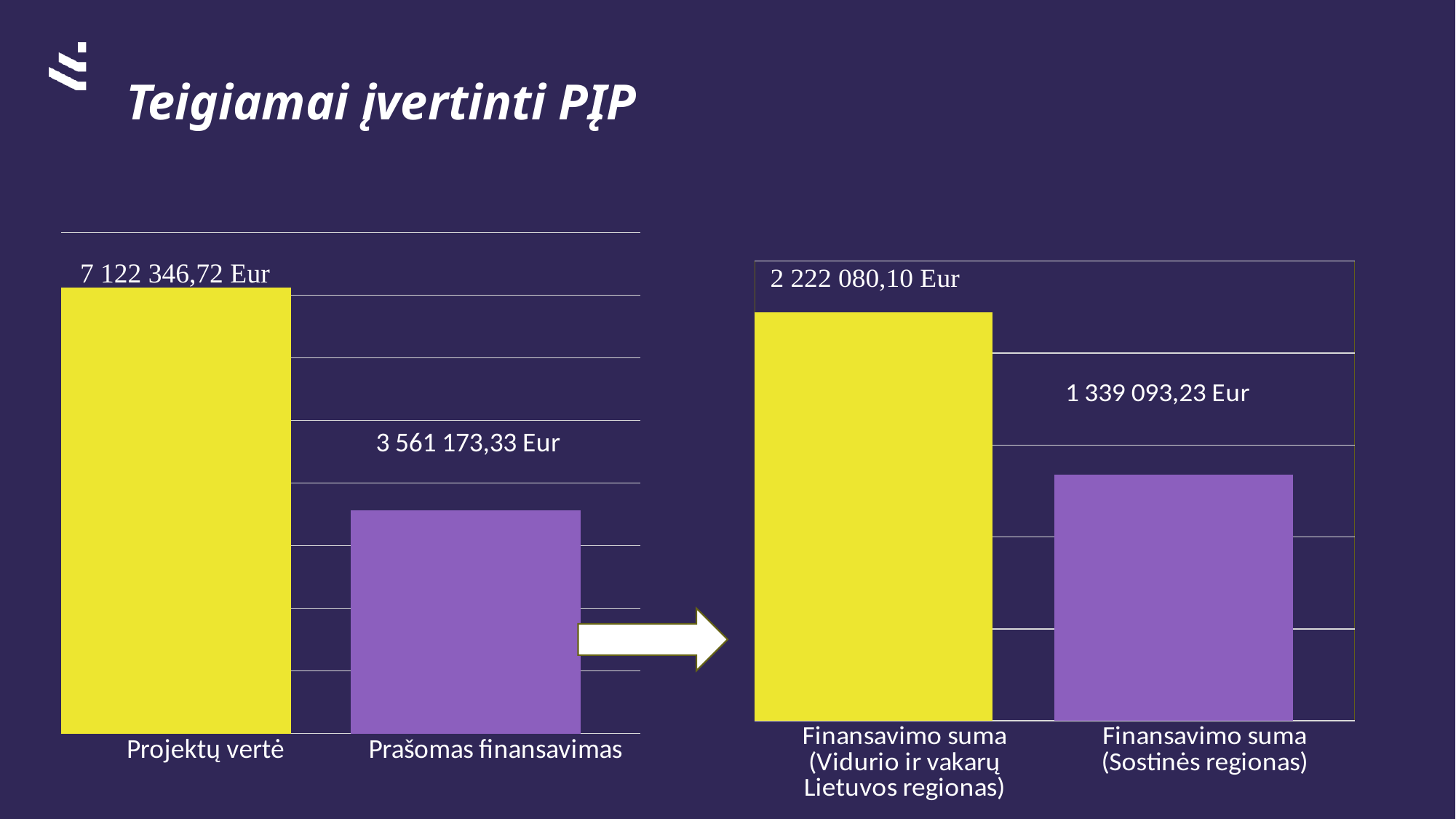
How many bars does the left chart show? 2 On the right chart, what is the difference between the Vidurio ir vakarų Lietuvos regionas and Sostinės regionas funding amounts? 882 986,87 Eur On the right chart, which is larger: Finansavimo suma (Vidurio ir vakarų Lietuvos regionas) or Finansavimo suma (Sostinės regionas)? Finansavimo suma (Vidurio ir vakarų Lietuvos regionas) On the left chart, what is the value for Projektų vertė? 7 122 346,72 Eur On the right chart, what is the value for Finansavimo suma (Sostinės regionas)? 1 339 093,23 Eur What type of chart is the right chart? Bar chart On the left chart, what is the difference between Projektų vertė and Prašomas finansavimas? 3 561 173,39 Eur On the left chart, what colour is the bar for Prašomas finansavimas? Purple On the right chart, which category has the lowest value? Finansavimo suma (Sostinės regionas) On the left chart, what is the value for Prašomas finansavimas? 3 561 173,33 Eur On the right chart, what is the value for Finansavimo suma (Vidurio ir vakarų Lietuvos regionas)? 2 222 080,10 Eur On the left chart, which category has the highest value? Projektų vertė